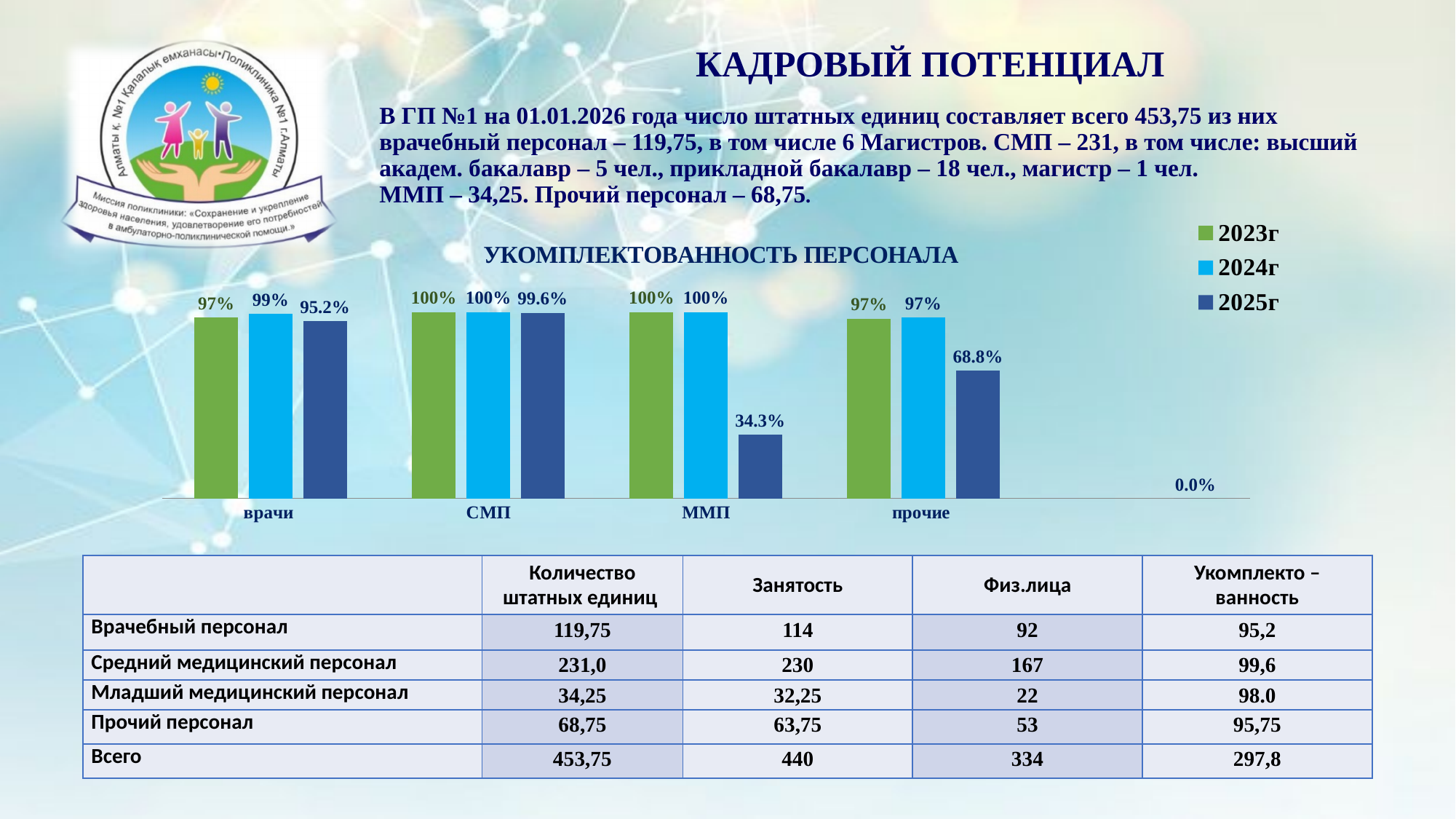
What is the difference between the 2024г and 2025г values for «ММП»? 65.7% What is the value for «СМП» in the 2025г series? 99.6% Which category has the highest value in the 2025г series? СМП Which legend entry is shown in green? 2023г What is the value for «прочие» in the 2025г series? 68.8% How many series does the legend of the chart list? 3 What is the value for «врачи» in the 2024г series? 99% What is the value for «ММП» in the 2025г series? 34.3% What is the value for «врачи» in the 2025г series? 95.2% Which is larger for «прочие»: the 2024г value or the 2025г value? 2024г What type of chart is shown under the title «УКОМПЛЕКТОВАННОСТЬ ПЕРСОНАЛА»? bar chart